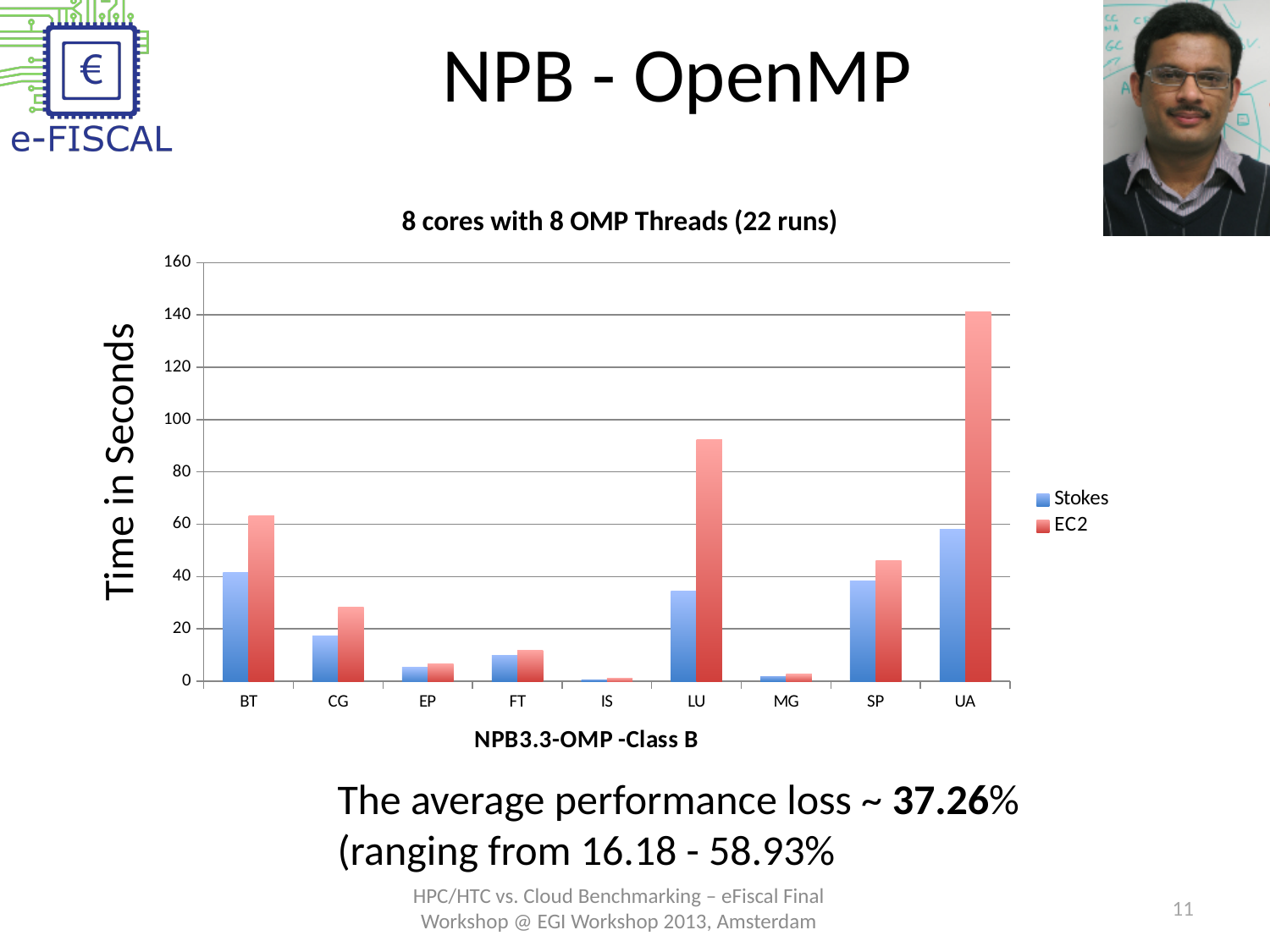
What kind of chart is shown on the slide? bar chart What is the title of the chart? 8 cores with 8 OMP Threads (22 runs) Is the EC2 value for LU greater or less than 80? greater How many benchmark categories are shown on the x axis? 9 How many series does the legend list? 2 Is the EC2 value for CG greater or less than 40? less Which category has the highest Stokes value? UA Is the EC2 value for UA greater or less than 120? greater Which is larger, the EC2 value for LU or the EC2 value for SP? LU Which category has the highest EC2 value? UA Which is larger, the Stokes value for BT or the Stokes value for CG? BT